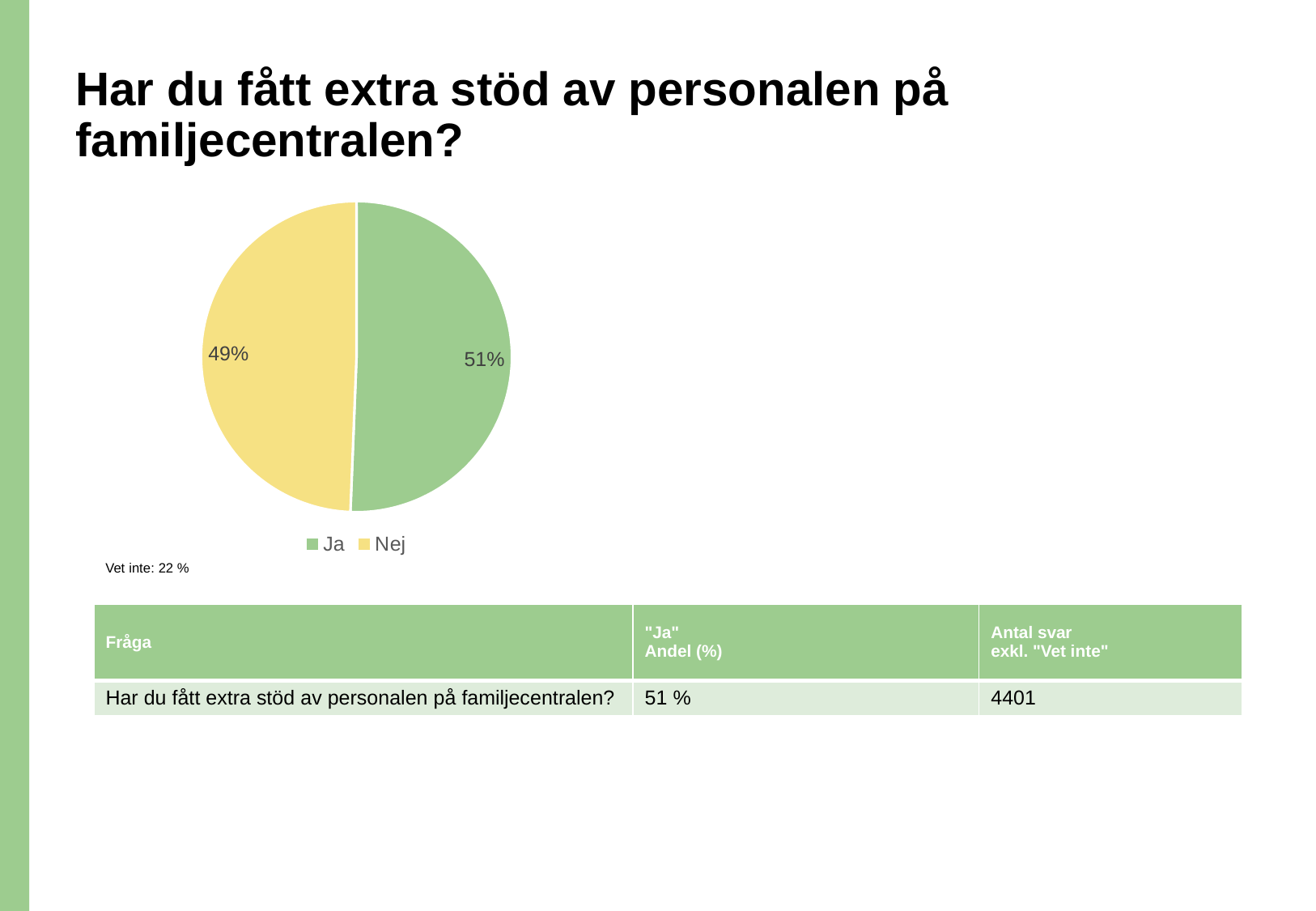
What percentage of the pie chart is the "Nej" slice? 49% Is the share of the "Ja" slice greater or less than 50%? greater What percentage of the pie chart is the "Ja" slice? 51% How many entries does the legend of the pie chart list? 2 What colour is the "Ja" slice in the pie chart? green What kind of chart is shown on the slide? pie chart What colour is the "Nej" slice in the pie chart? yellow What is the difference in percentage points between the "Ja" and "Nej" slices? 2 How many slices does the pie chart have? 2 Which slice of the pie chart is larger, "Ja" or "Nej"? Ja Which category has the smallest share in the pie chart? Nej